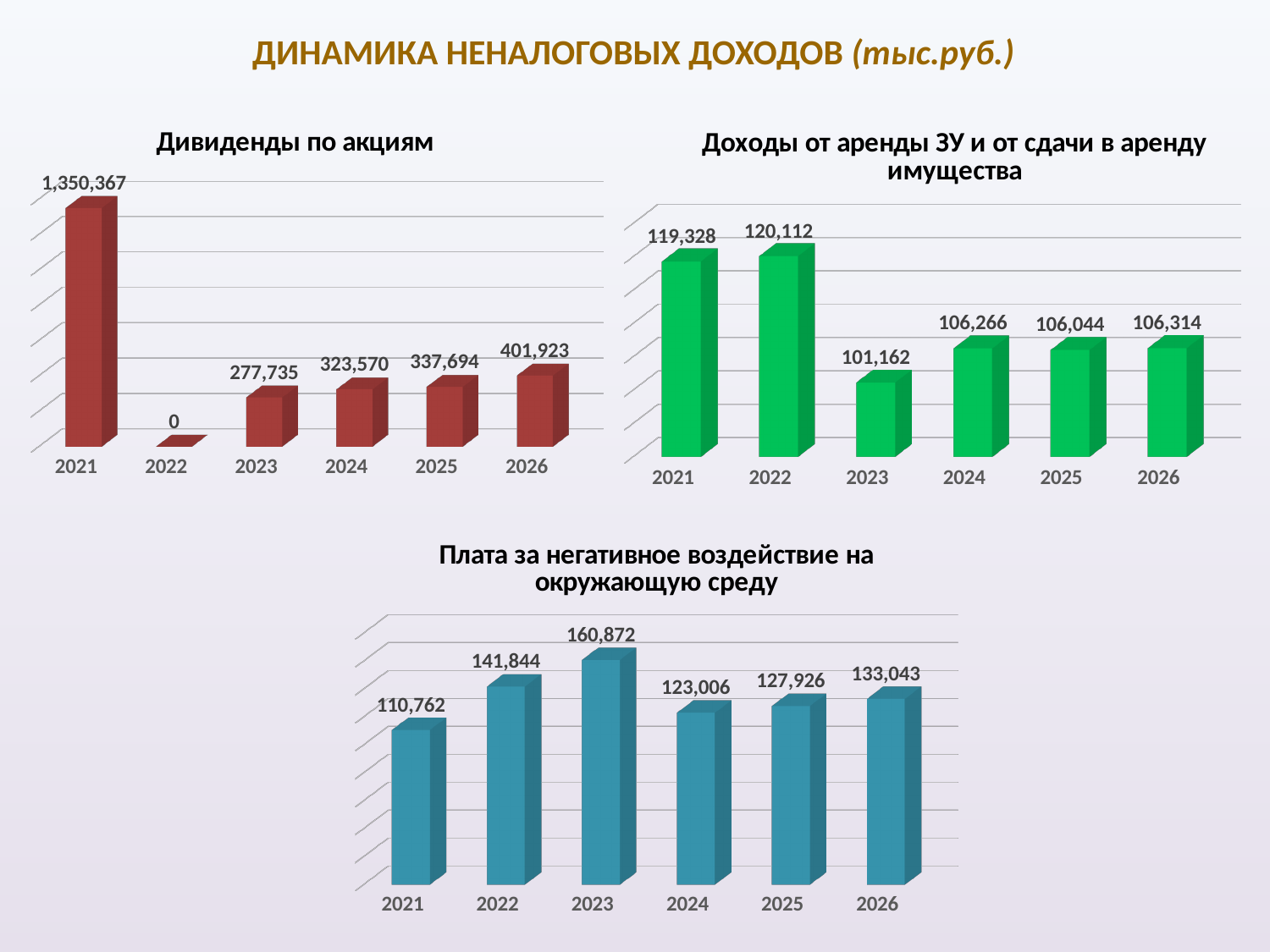
In the 'Дивиденды по акциям' chart, what is the value for 2021? 1,350,367 In the 'Дивиденды по акциям' chart, what is the difference between the values for 2026 and 2025? 64,229 In the 'Доходы от аренды ЗУ и от сдачи в аренду имущества' chart, what is the value for 2023? 101,162 In the 'Плата за негативное воздействие на окружающую среду' chart, which year has the lowest value? 2021 In the 'Дивиденды по акциям' chart, which year has the highest value? 2021 In the 'Дивиденды по акциям' chart, what is the value for 2022? 0 In the 'Доходы от аренды ЗУ и от сдачи в аренду имущества' chart, which year has the lowest value? 2023 How many years are shown in the 'Плата за негативное воздействие на окружающую среду' chart? 6 In the 'Плата за негативное воздействие на окружающую среду' chart, what is the value for 2023? 160,872 In the 'Доходы от аренды ЗУ и от сдачи в аренду имущества' chart, which is larger, the value for 2021 or 2022? 2022 In the 'Плата за негативное воздействие на окружающую среду' chart, what is the difference between the values for 2023 and 2022? 19,028 What type of chart is the 'Дивиденды по акциям' chart? Bar chart